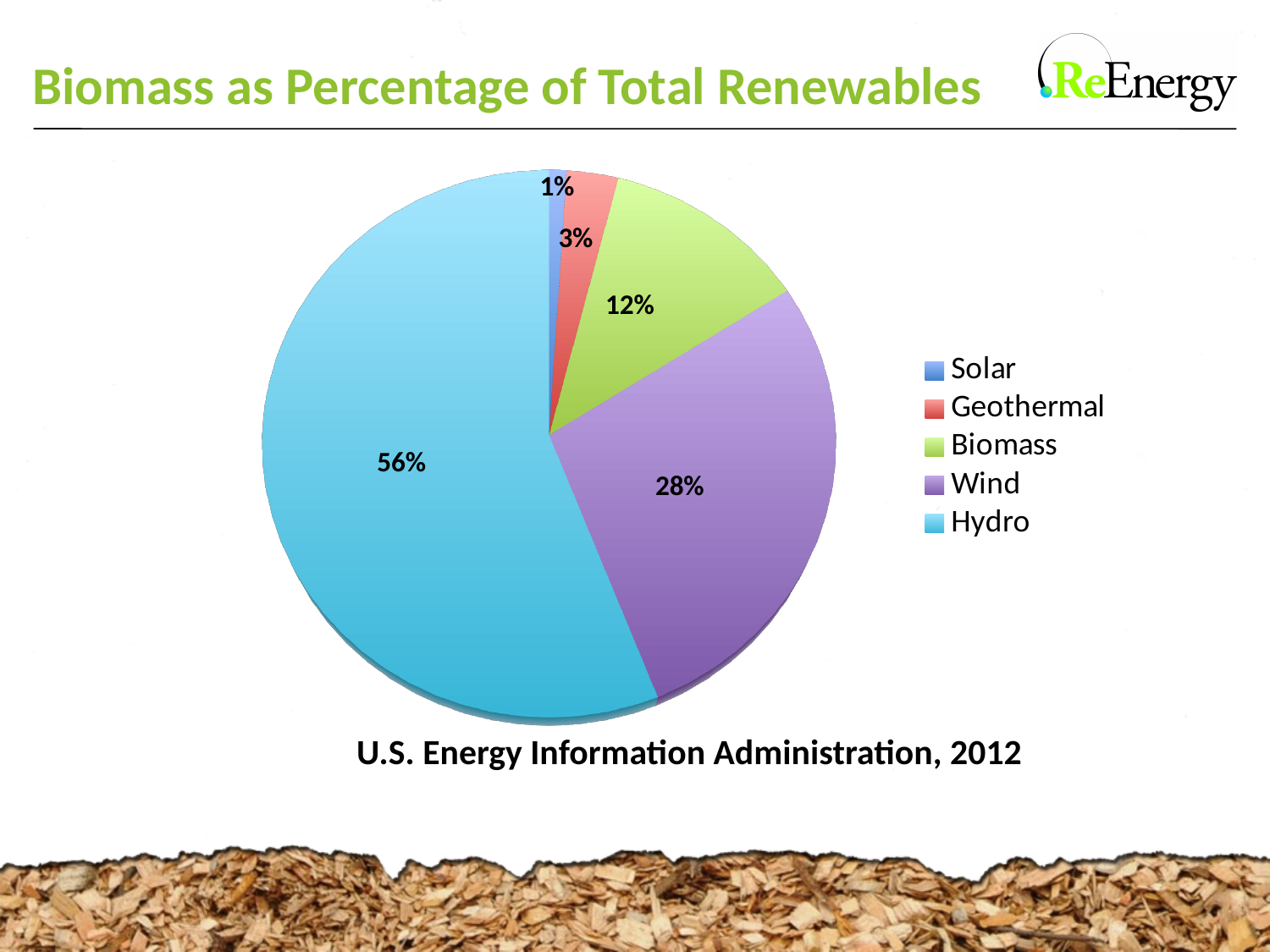
What is the difference in percentage points between Hydro and Wind? 28 Which category has the largest share of the pie? Hydro Which category has the smallest share of the pie? Solar What percentage of total renewables does Hydro account for? 56% What percentage of total renewables does Solar account for? 1% What percentage of total renewables does Geothermal account for? 3% What data source is cited below the chart? U.S. Energy Information Administration, 2012 What percentage of total renewables does Wind account for? 28% What percentage of total renewables does Biomass account for? 12% Which is larger, the share for Biomass or the share for Geothermal? Biomass What type of chart is shown on the slide? pie chart How many categories does the legend list? 5